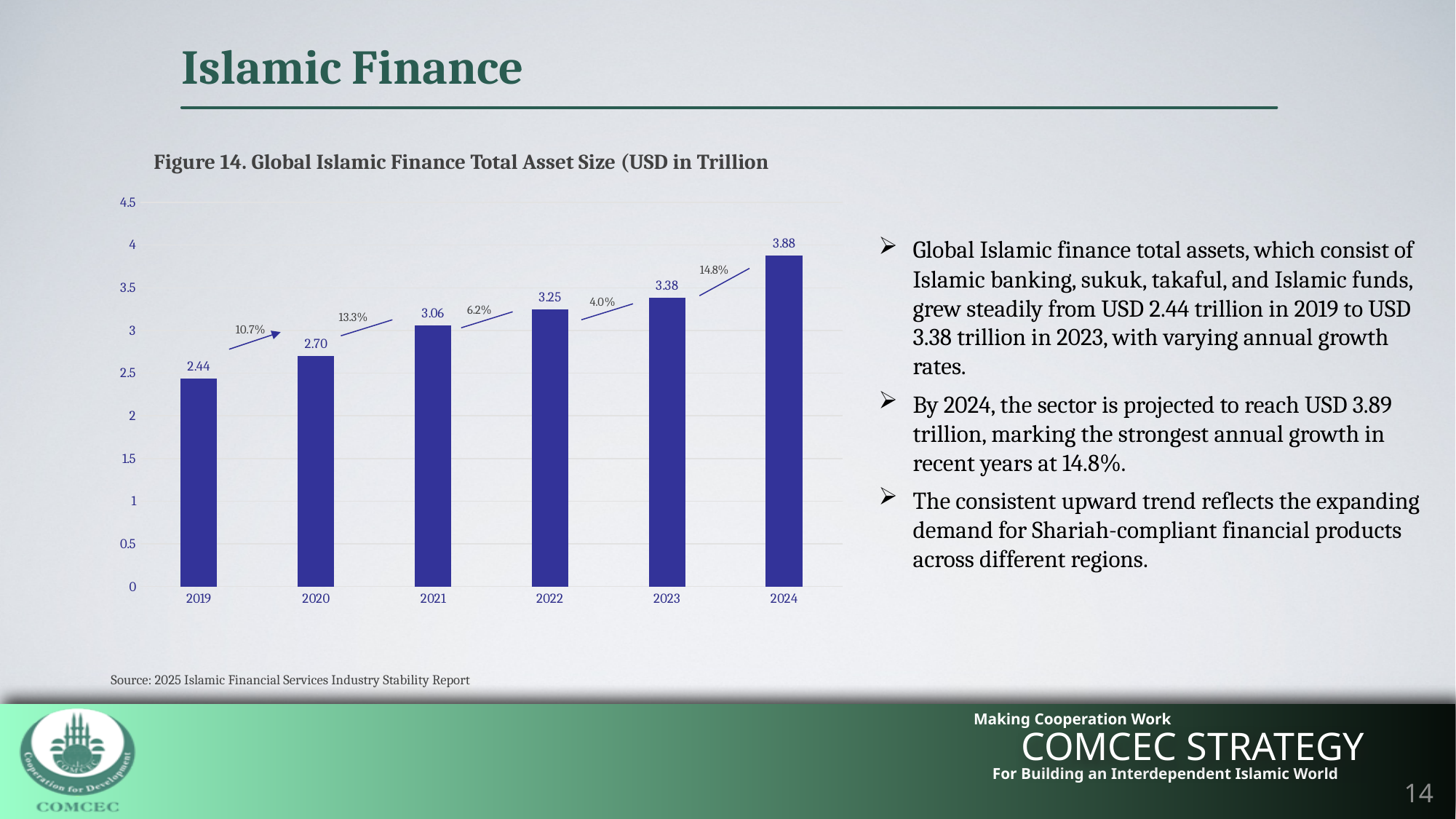
What kind of chart is this? bar chart Do the values rise or fall from 2019 to 2024? rise Which year has the highest value? 2024 What is the difference between the values for 2023 and 2019? 0.94 What is the value for 2024? 3.88 How many years are shown on the x axis? 6 What is the value for 2022? 3.25 What is the value for 2019? 2.44 Is the value for 2023 greater or less than 3? greater Which year has the lowest value? 2019 Which is larger, the value for 2021 or the value for 2020? 2021 What growth rate is labelled between 2023 and 2024? 14.8%